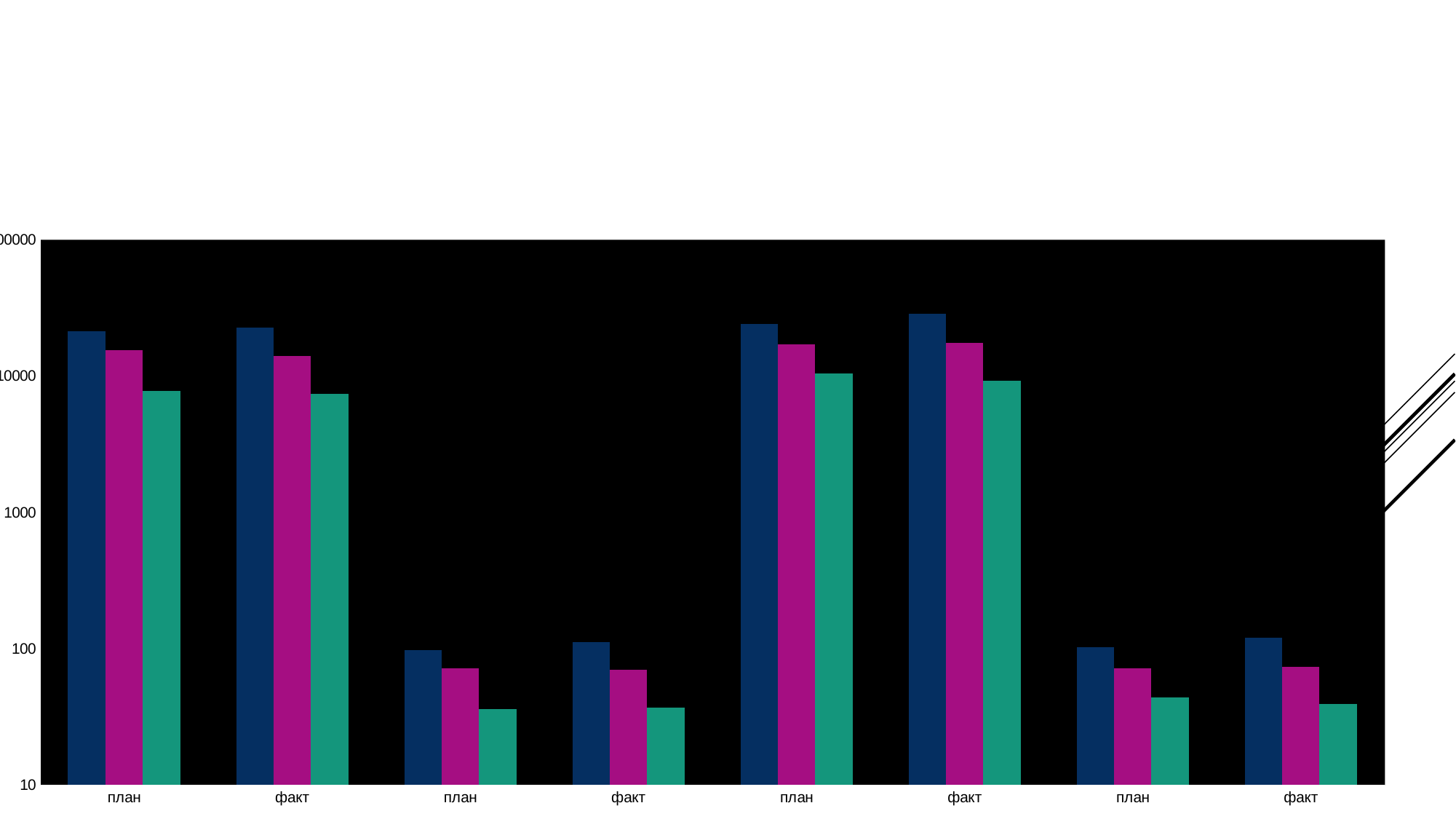
In the fifth group from the left ('план'), is the value of the dark blue bar greater or less than 10000? greater In the first 'план' group from the left, is the value of the dark blue bar greater or less than 10000? greater What is the lowest tick value shown on the y axis? 10 In the second group from the left ('факт'), is the value of the magenta bar greater or less than 10000? greater In the first 'план' group from the left, which is larger: the dark blue bar or the teal bar? the dark blue bar Which colour of bar is the tallest in every category group? dark blue How many category groups are shown along the x axis? 8 How many bars are plotted in each category group? 3 What kind of chart is shown on the slide? bar chart